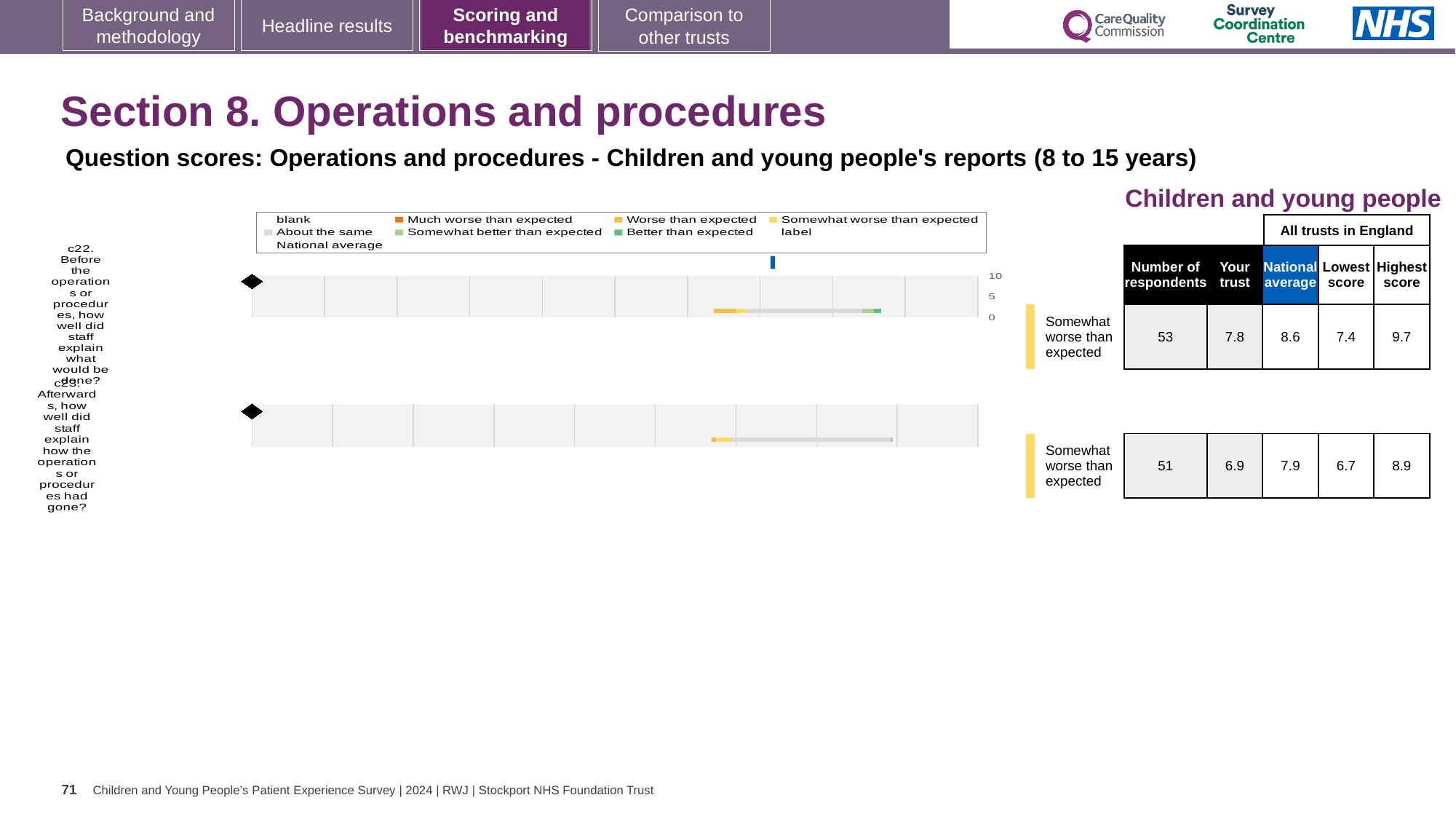
For question c22, how much higher is the national average than the trust's score? 0.8 Which question has the higher 'Your trust' score, c22 or c23? c22 For question c23, what is the difference between the highest and lowest scores among all trusts in England? 2.2 What is the highest score among all trusts in England for question c23? 8.9 What kind of chart is used to show the question scores on this slide? Bar chart What benchmark category is shown for the trust's score on question c22? Somewhat worse than expected How many questions are plotted on this slide? 2 For question c23 (Afterwards, how well did staff explain how the operations or procedures had gone?), what is the national average score? 7.9 For question c22 (Before the operations or procedures, how well did staff explain what would be done?), what is the 'Your trust' score? 7.8 How many respondents answered question c22? 53 How many respondents answered question c23? 51 What is the lowest score among all trusts in England for question c22? 7.4